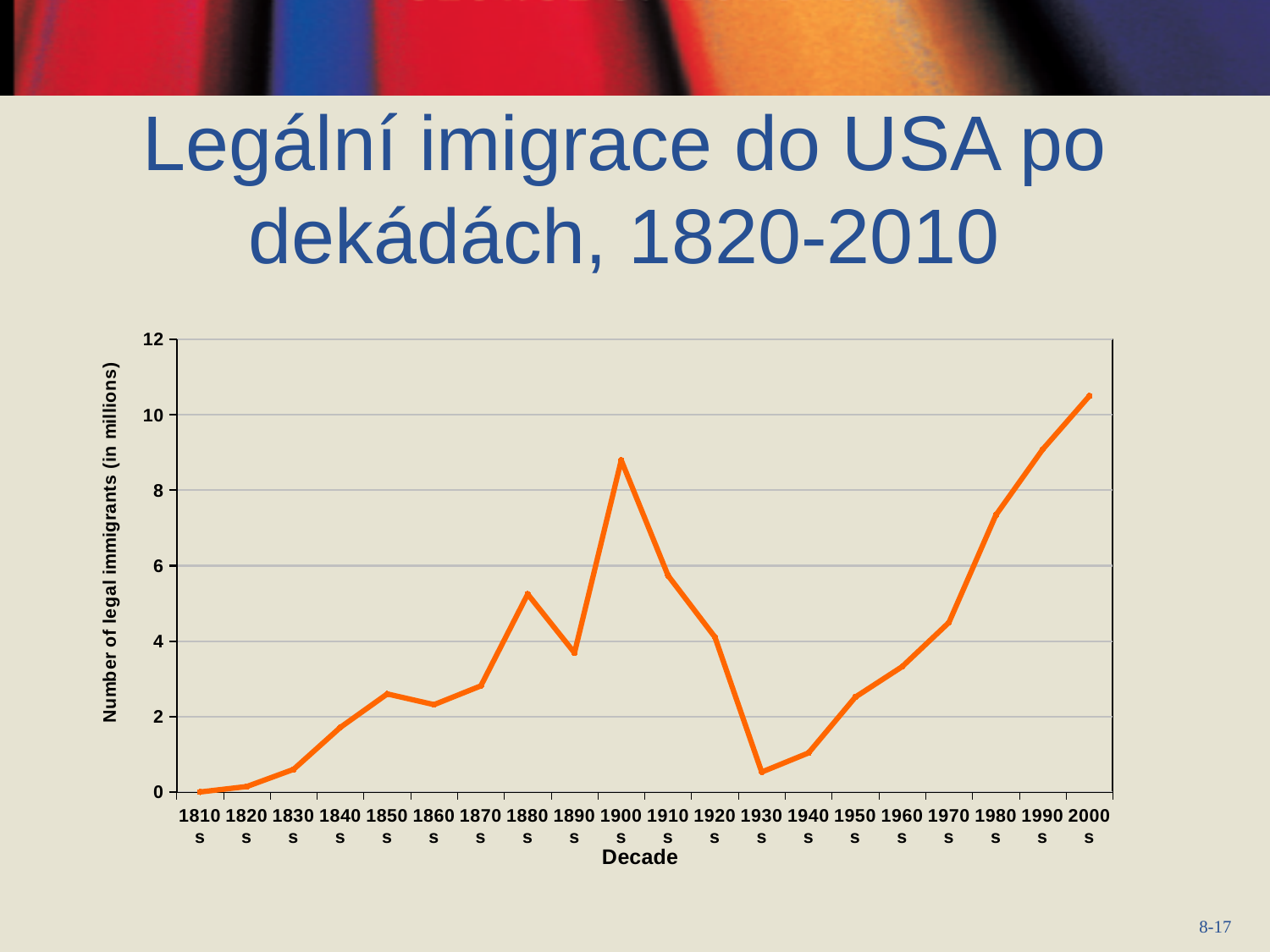
Do the values rise or fall from the 1930s to the 2000s? rise Which decade has a higher number of legal immigrants, the 1880s or the 1890s? 1880s Is the value for the 1900s greater or less than 8 million? greater What kind of chart is shown on the slide? line chart Which decade has a higher number of legal immigrants, the 1920s or the 1930s? 1920s Is the value for the 2000s greater or less than 10 million? greater How many decades are plotted along the x axis of the chart? 20 Which decade has the highest number of legal immigrants in the chart? 2000s Is the value for the 1930s greater or less than 2 million? less What is the title of the vertical axis of the chart? Number of legal immigrants (in millions) Which decade has the lowest number of legal immigrants in the chart? 1810s